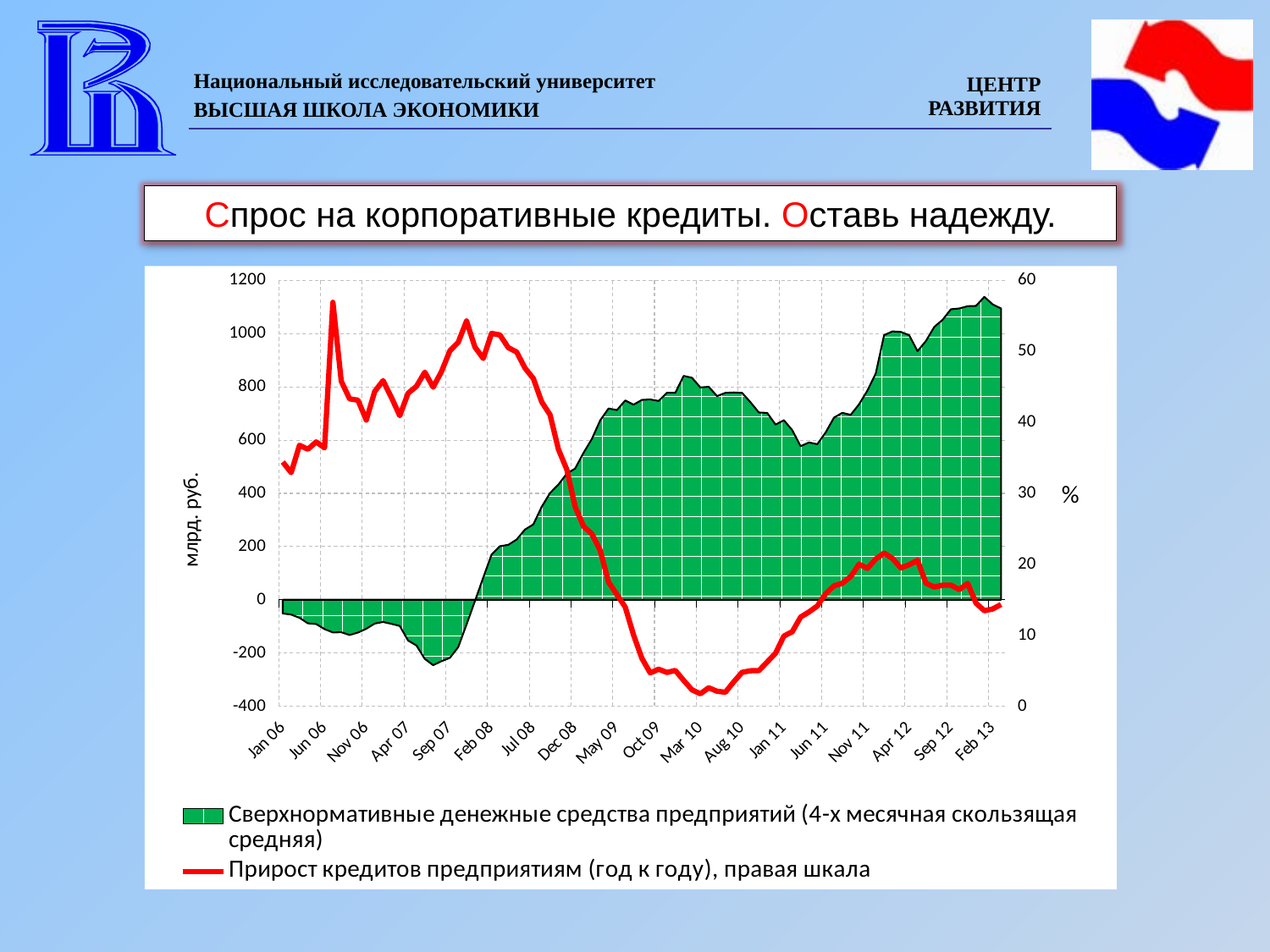
How many series does the legend list? 2 Which series is plotted on the right scale according to the legend? Прирост кредитов предприятиям (год к году), правая шкала Is the value of the green area (Сверхнормативные денежные средства предприятий) at Feb 13 greater or less than 1000 on the left axis? greater Is the value of the red line (Прирост кредитов предприятиям) at Feb 13 greater or less than 20 on the right axis? less Is the value of the red line (Прирост кредитов предприятиям) at Mar 10 greater or less than 10 on the right axis? less How many date labels are shown on the x axis? 18 What is the title of the slide's chart? Спрос на корпоративные кредиты. Оставь надежду. Does the green area (Сверхнормативные денежные средства предприятий) rise or fall overall between Feb 08 and Feb 13? rise What kind of chart is shown on the slide? A combined area and line chart Does the red line (Прирост кредитов предприятиям) rise or fall between Feb 08 and Mar 10? fall